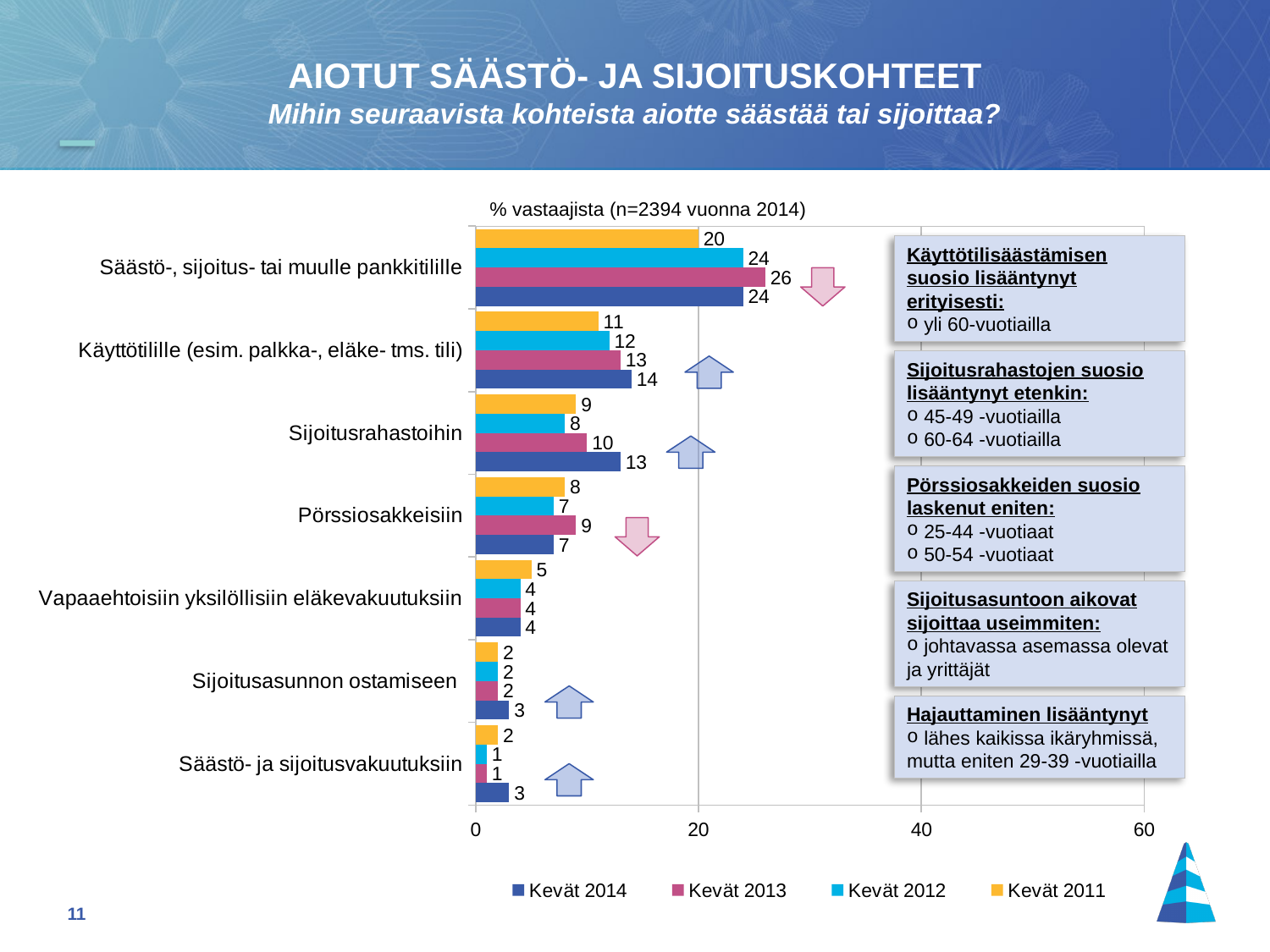
Which series has the highest value for Säästö-, sijoitus- tai muulle pankkitilille? Kevät 2013 What kind of chart is shown on the slide? Bar chart How many categories are shown on the chart? 7 What is the Kevät 2014 value for Säästö- ja sijoitusvakuutuksiin? 3 What is the difference between the Kevät 2014 and Kevät 2011 values for Sijoitusrahastoihin? 4 Which category has the highest Kevät 2014 value? Säästö-, sijoitus- tai muulle pankkitilille How many series does the legend list? 4 What is the Kevät 2013 value for Sijoitusrahastoihin? 10 What is the Kevät 2014 value for Säästö-, sijoitus- tai muulle pankkitilille? 24 Which is larger for Pörssiosakkeisiin: the Kevät 2013 value or the Kevät 2014 value? Kevät 2013 Is the Kevät 2013 value for Säästö-, sijoitus- tai muulle pankkitilille greater or less than 20? greater What is the Kevät 2011 value for Käyttötilille (esim. palkka-, eläke- tms. tili)? 11